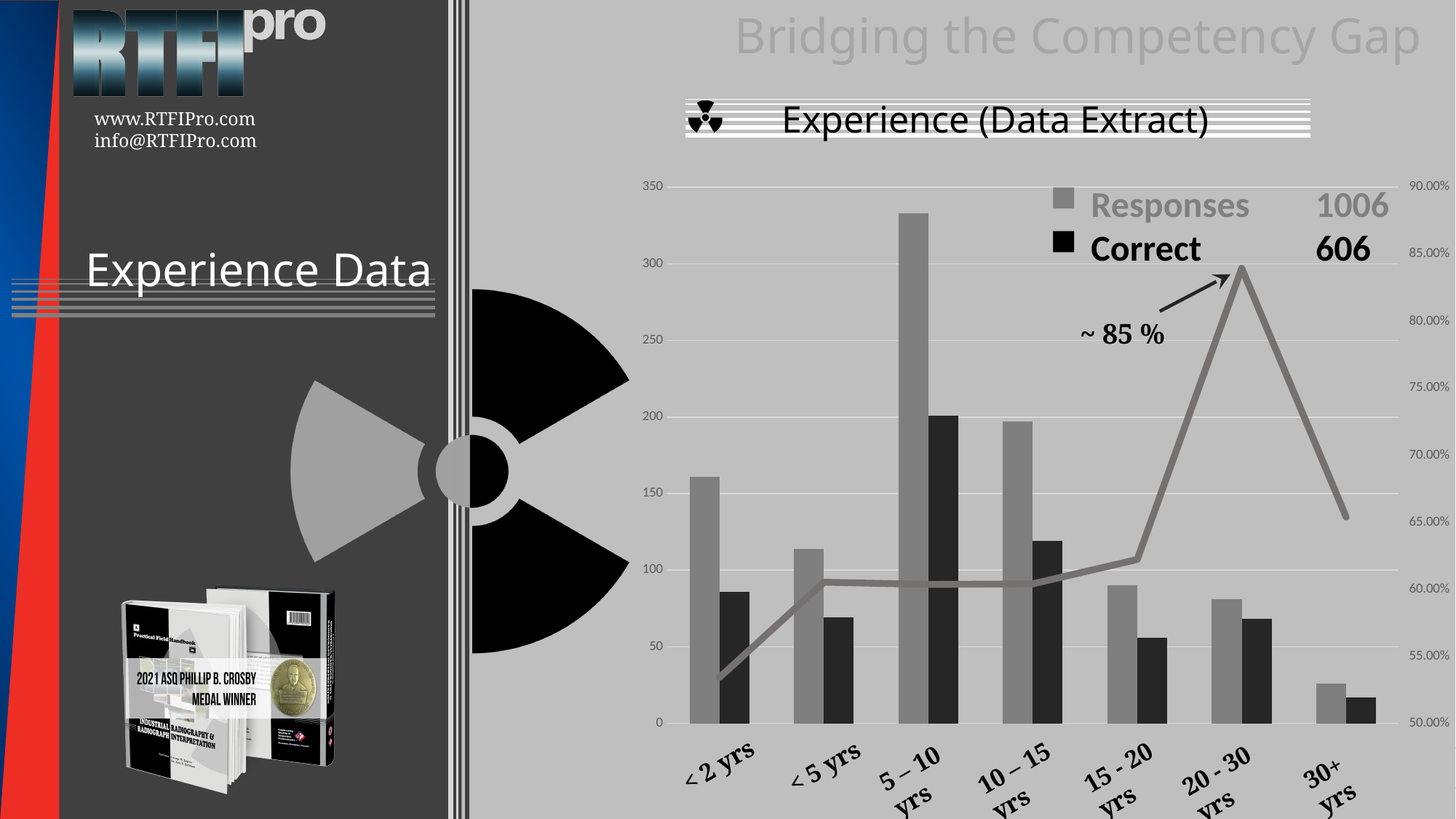
Which has more Responses, < 2 yrs or < 5 yrs? < 2 yrs What is the title of the chart? Experience (Data Extract) Which experience category has the lowest number of Responses? 30+ yrs How many experience categories are shown on the x axis of the chart? 7 How many series does the chart legend list? 2 Is the Responses value for 5 – 10 yrs greater or less than 300? greater Is the Correct value for 10 – 15 yrs greater or less than 100? greater Which experience category has the highest Correct bar? 5 – 10 yrs Which experience category has the highest number of Responses? 5 – 10 yrs What total number of Responses is shown next to the legend? 1006 Does the percentage line rise or fall from 20 - 30 yrs to 30+ yrs? fall Is the Responses value for 30+ yrs greater or less than 50? less